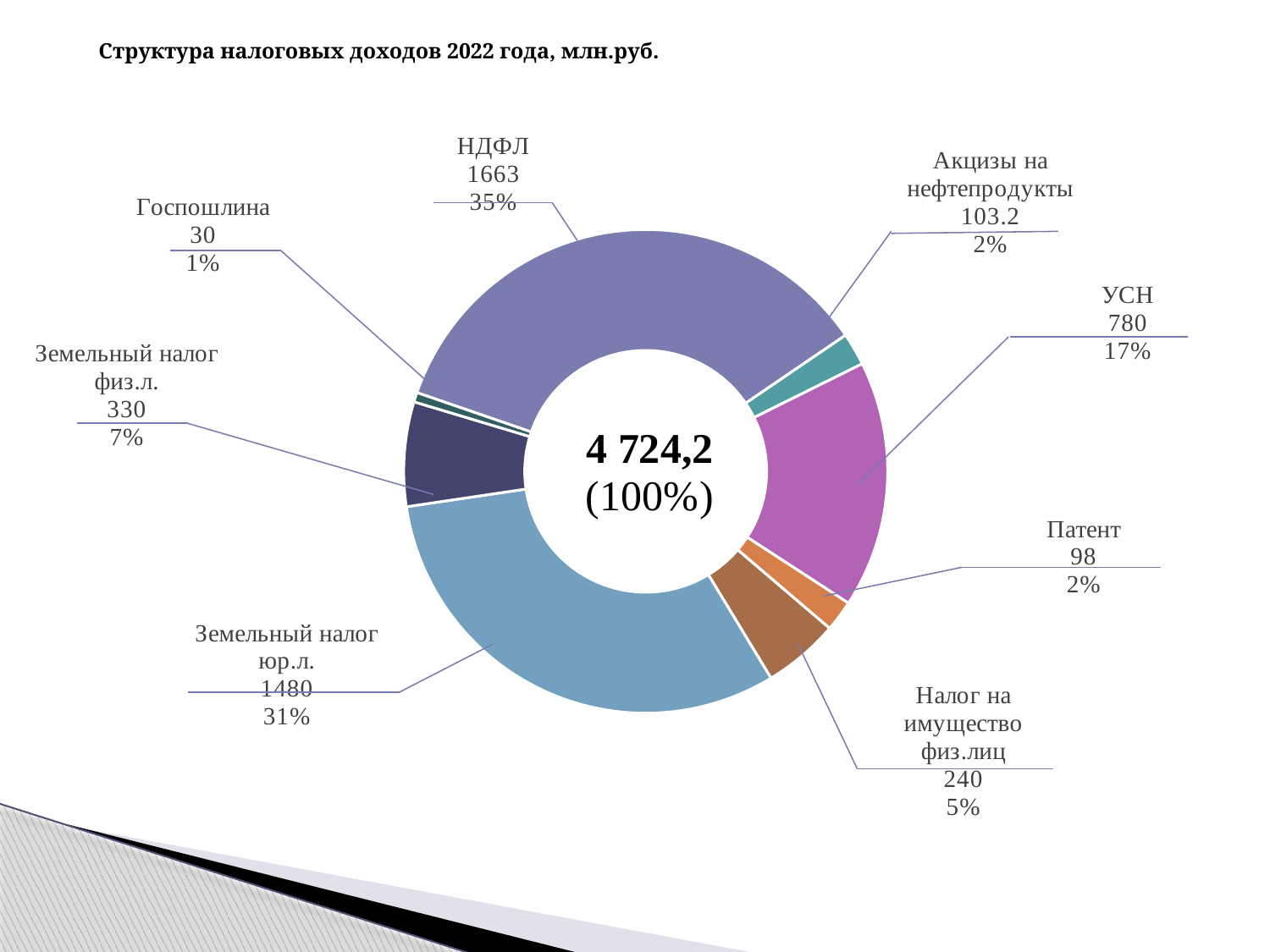
What is the value for УСН? 780 What total value is shown in the centre of the chart? 4 724,2 What share of the chart does Земельный налог юр.л. represent? 31% What share of the chart does Налог на имущество физ.лиц represent? 5% What is the value for Акцизы на нефтепродукты? 103.2 How many categories are shown in the chart? 8 Which is larger, the value for УСН or the value for Земельный налог физ.л.? УСН Which category has the smallest value? Госпошлина What is the value for НДФЛ? 1663 What kind of chart is shown on the slide? Doughnut (pie) chart What is the difference between the values for НДФЛ and Земельный налог юр.л.? 183 Which category has the largest share of the chart? НДФЛ